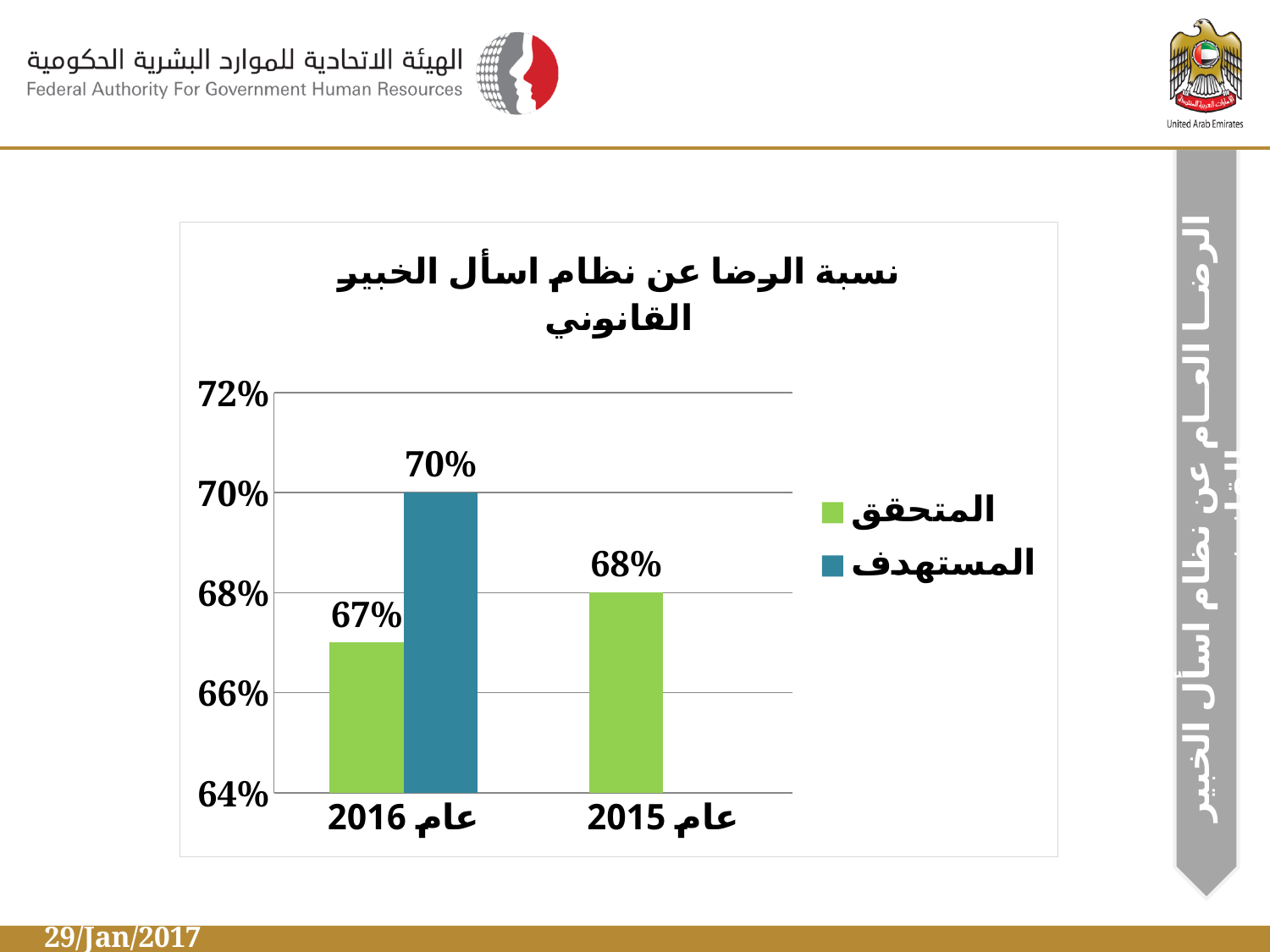
What is the value of المستهدف (target) for عام 2016? 70% How many year categories are shown on the x axis? 2 What is the difference between the المتحقق (achieved) values for عام 2015 and عام 2016? 1% What is the value of المتحقق (achieved) for عام 2015? 68% What is the difference between the المستهدف (target) and المتحقق (achieved) values for عام 2016? 3% Which colour represents المستهدف (target) in the legend? Blue What is the value of المتحقق (achieved) for عام 2016? 67% How many series does the legend list? 2 Which bar shows the lowest value in the chart? المتحقق for عام 2016 (67%) What kind of chart is shown on the slide? Bar chart Which year has the higher المتحقق (achieved) value, عام 2016 or عام 2015? عام 2015 Which bar shows the highest value in the chart? المستهدف for عام 2016 (70%)